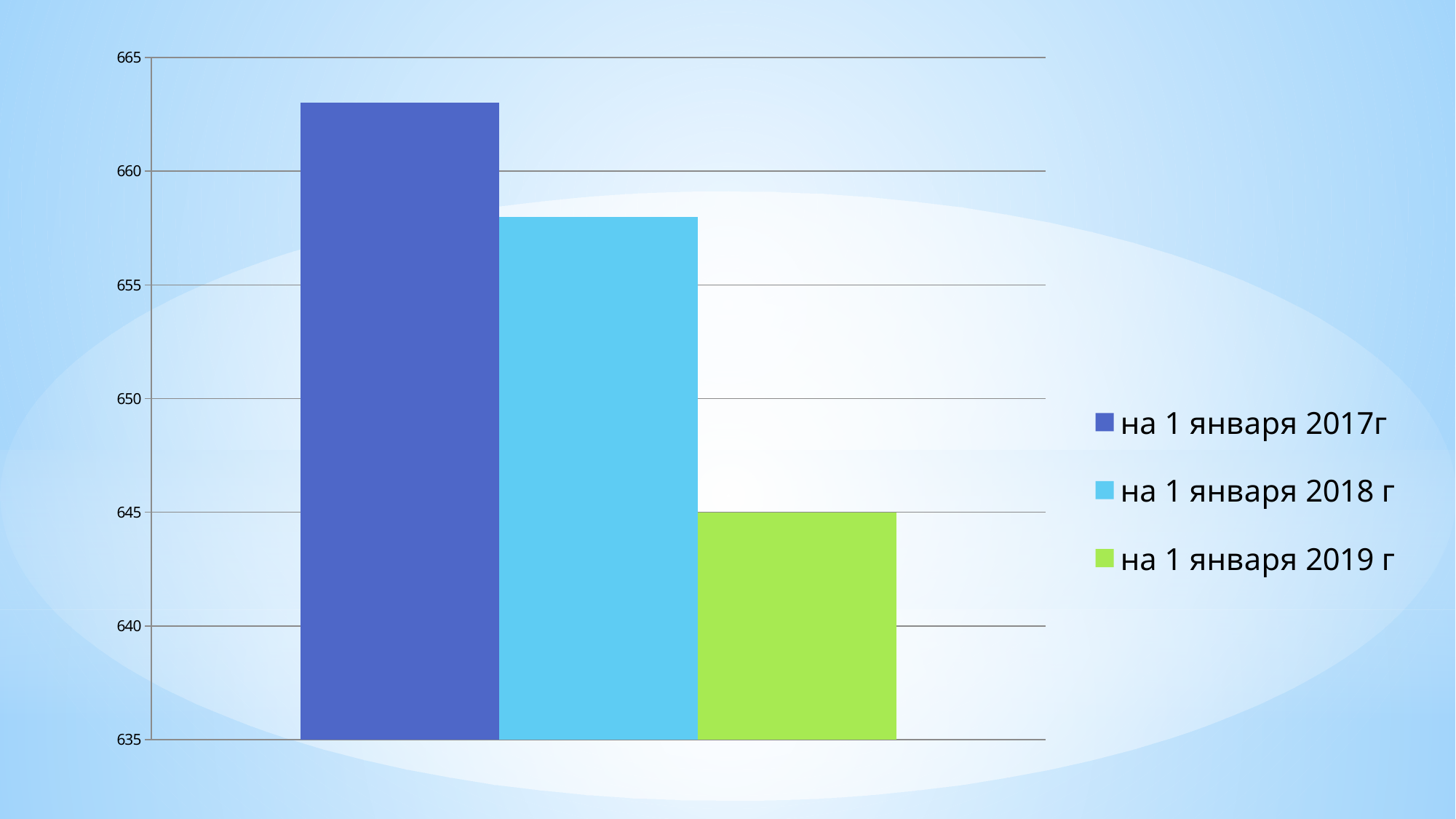
What is the value for "на 1 января 2019 г"? 645 Which is larger, the value for "на 1 января 2017г" or the value for "на 1 января 2018 г"? на 1 января 2017г How many series does the legend list? 3 How many bars are plotted on the chart? 3 Is the value for "на 1 января 2018 г" greater or less than 660? less Is the value for "на 1 января 2017г" greater or less than 660? greater Is the value for "на 1 января 2018 г" greater or less than 655? greater Which series has the highest value? на 1 января 2017г What colour is the bar for "на 1 января 2019 г"? green Which series has the lowest value? на 1 января 2019 г Do the values rise or fall from the 2017 bar to the 2019 bar? fall What kind of chart is shown on the slide? bar chart